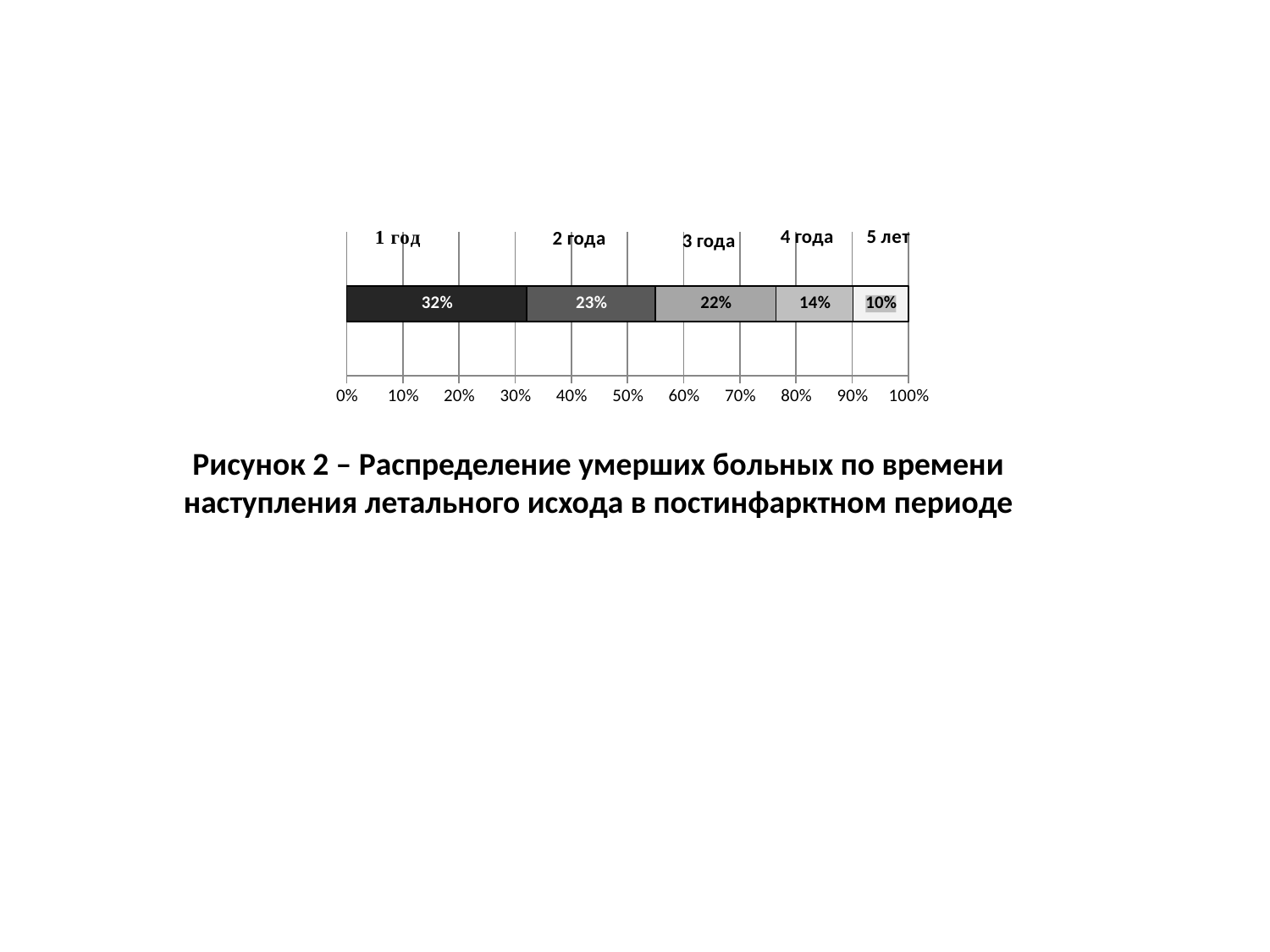
Which segment has the smallest share? 5 лет Which is larger, the 2 года segment or the 4 года segment? 2 года What value is shown for the 4 года segment? 14% Which segment has the largest share? 1 год What value is shown for the 3 года segment? 22% What share of deaths occurred in the 1 год (1 year) segment? 32% What value is shown for the 5 лет segment? 10% Do the segment values rise or fall from 1 год to 5 лет? Fall What is the difference between the 1 год and 5 лет segments? 22% What type of chart is shown on the slide? Stacked bar chart What value is shown for the 2 года segment? 23% How many segments does the stacked bar contain? 5